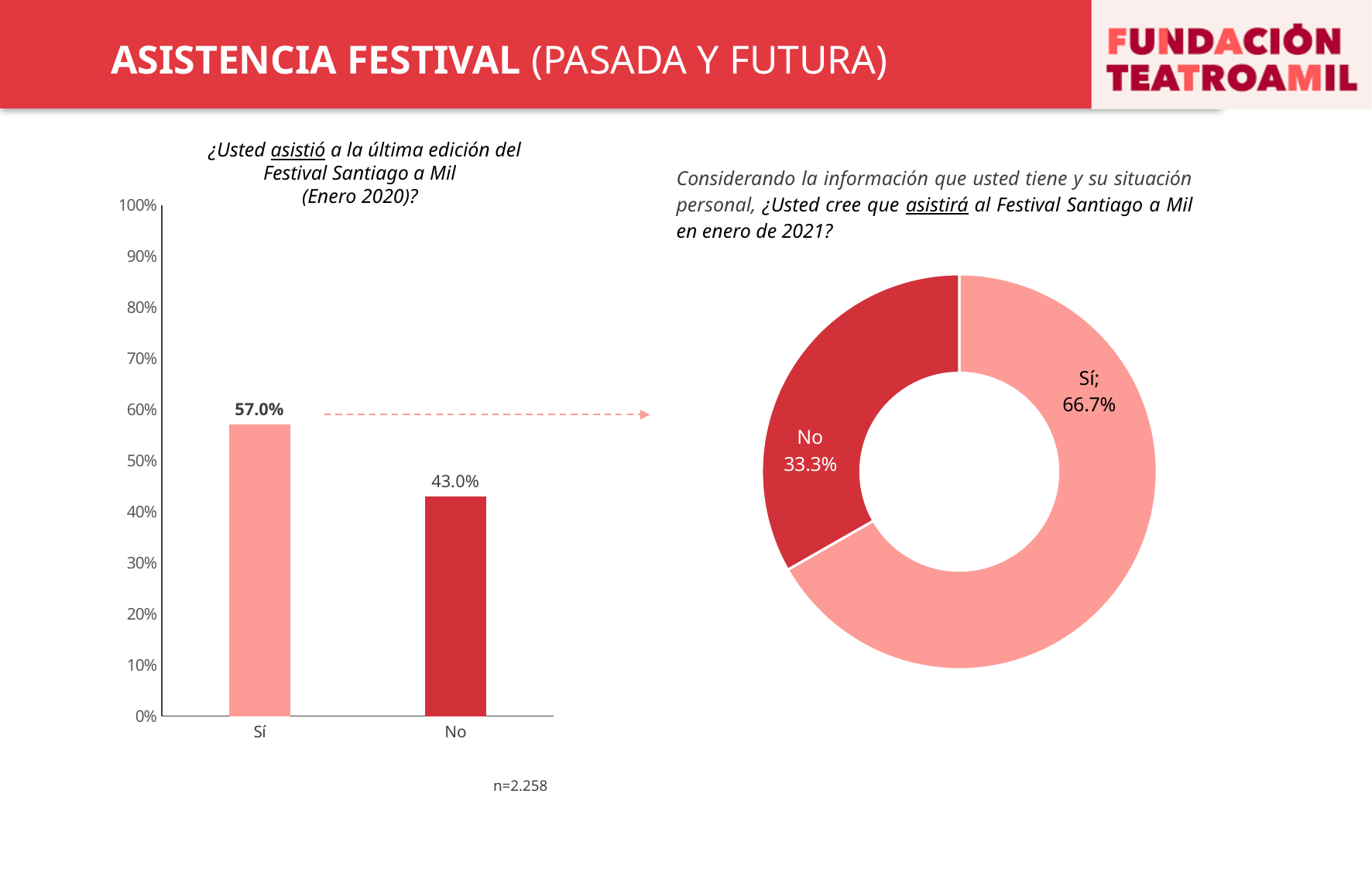
What kind of chart is on the left side of the slide? bar chart In the bar chart on the left, what is the value for Sí? 57.0% In the bar chart on the left, what is the difference between the values for Sí and No? 14.0% What is the sample size (n) shown below the bar chart on the left? n=2.258 In the bar chart on the left, which category has the lowest value? No In the bar chart on the left, what is the value for No? 43.0% In the bar chart on the left, which category has the highest value? Sí How many categories are shown in the bar chart on the left? 2 In the doughnut chart on the right, what share does No have? 33.3% In the doughnut chart on the right, what share does Sí have? 66.7% In the bar chart on the left, is the value for No greater or less than 50%? less In the doughnut chart on the right, which is larger, Sí or No? Sí